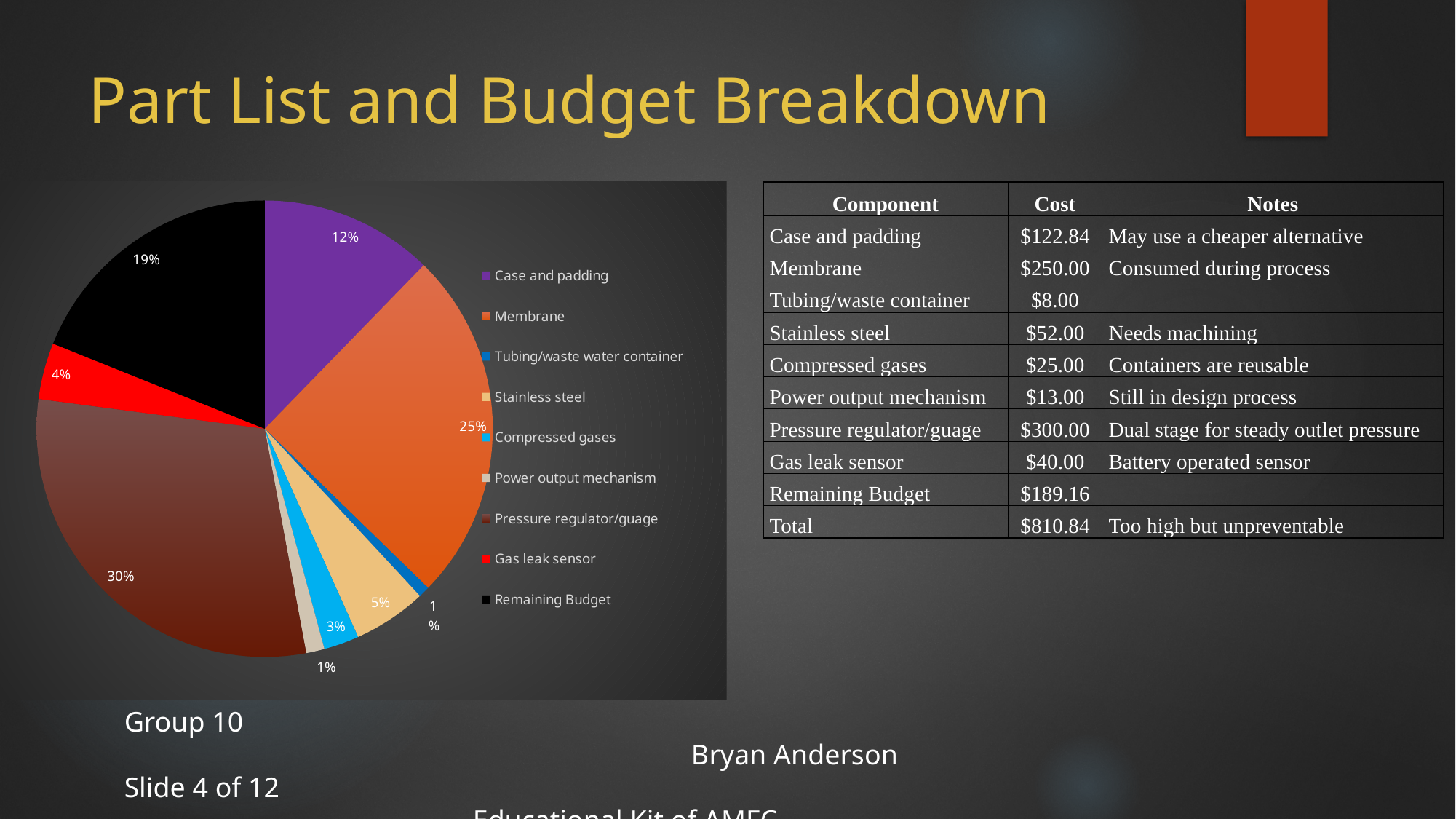
What colour is the Remaining Budget slice in the pie chart? black What percentage does the Remaining Budget slice show? 19% What is the combined percentage of the Case and padding and Membrane slices? 37% What percentage is shown for Gas leak sensor? 4% What is the difference in percentage points between the Pressure regulator/guage slice and the Membrane slice? 5 What percentage of the pie chart does Pressure regulator/guage account for? 30% What kind of chart is shown on the slide? pie chart What is the value shown for Membrane in the pie chart? 25% Which slice is larger, Stainless steel or Compressed gases? Stainless steel How many categories are listed in the pie chart's legend? 9 Which category has the largest slice of the pie chart? Pressure regulator/guage What is the value labelled for Case and padding in the pie chart? 12%